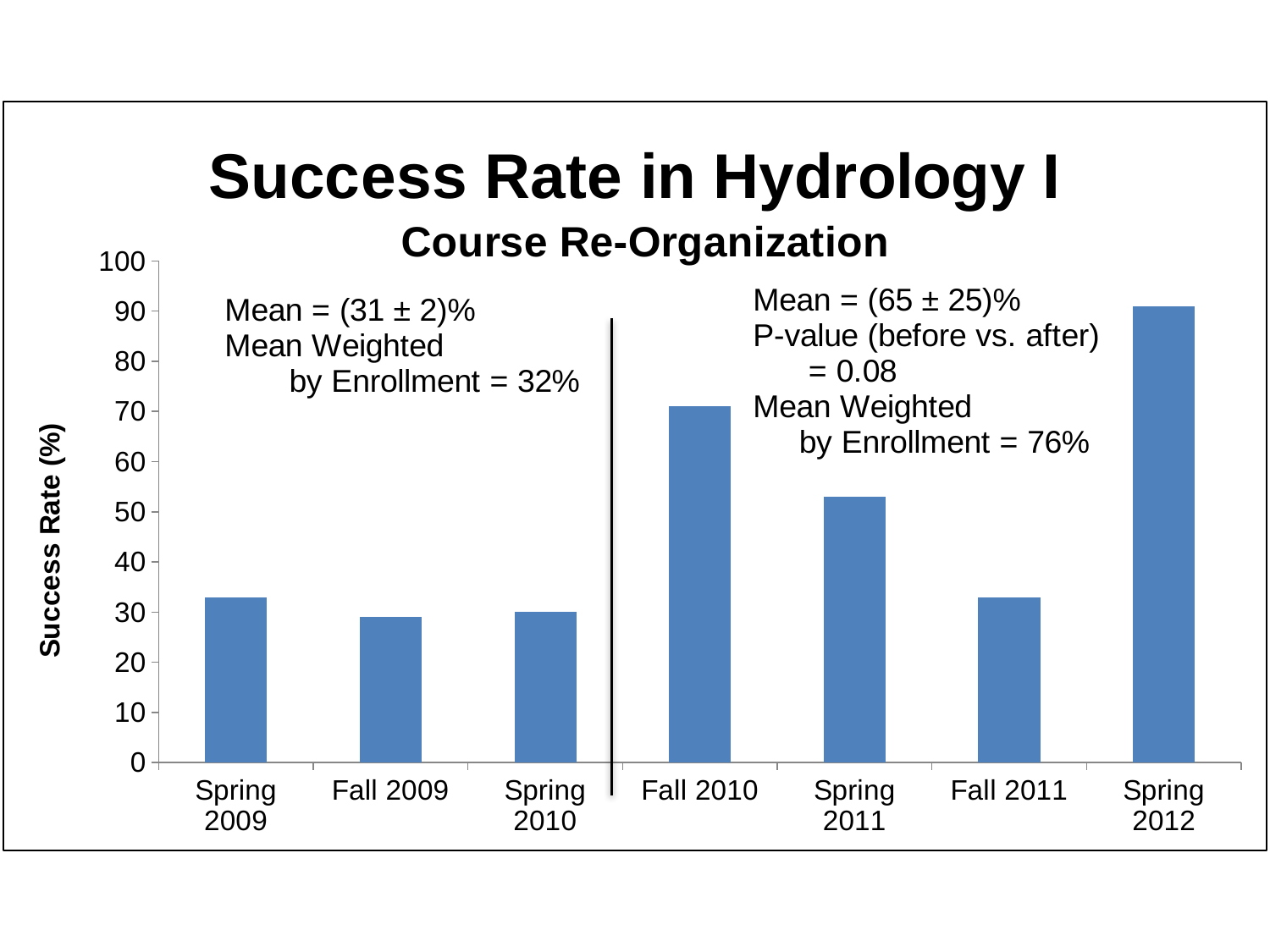
Which has a higher success rate, Fall 2010 or Spring 2011? Fall 2010 Is the success rate for Spring 2011 greater or less than 50? greater How many semesters (categories) are plotted on the chart? 7 Is the success rate for Spring 2009 greater or less than 40? less What is the title of the chart? Success Rate in Hydrology I Which semester has the highest success rate? Spring 2012 Which has a higher success rate, Fall 2011 or Spring 2012? Spring 2012 What type of chart is shown on the slide? bar chart What is the label on the vertical axis? Success Rate (%)